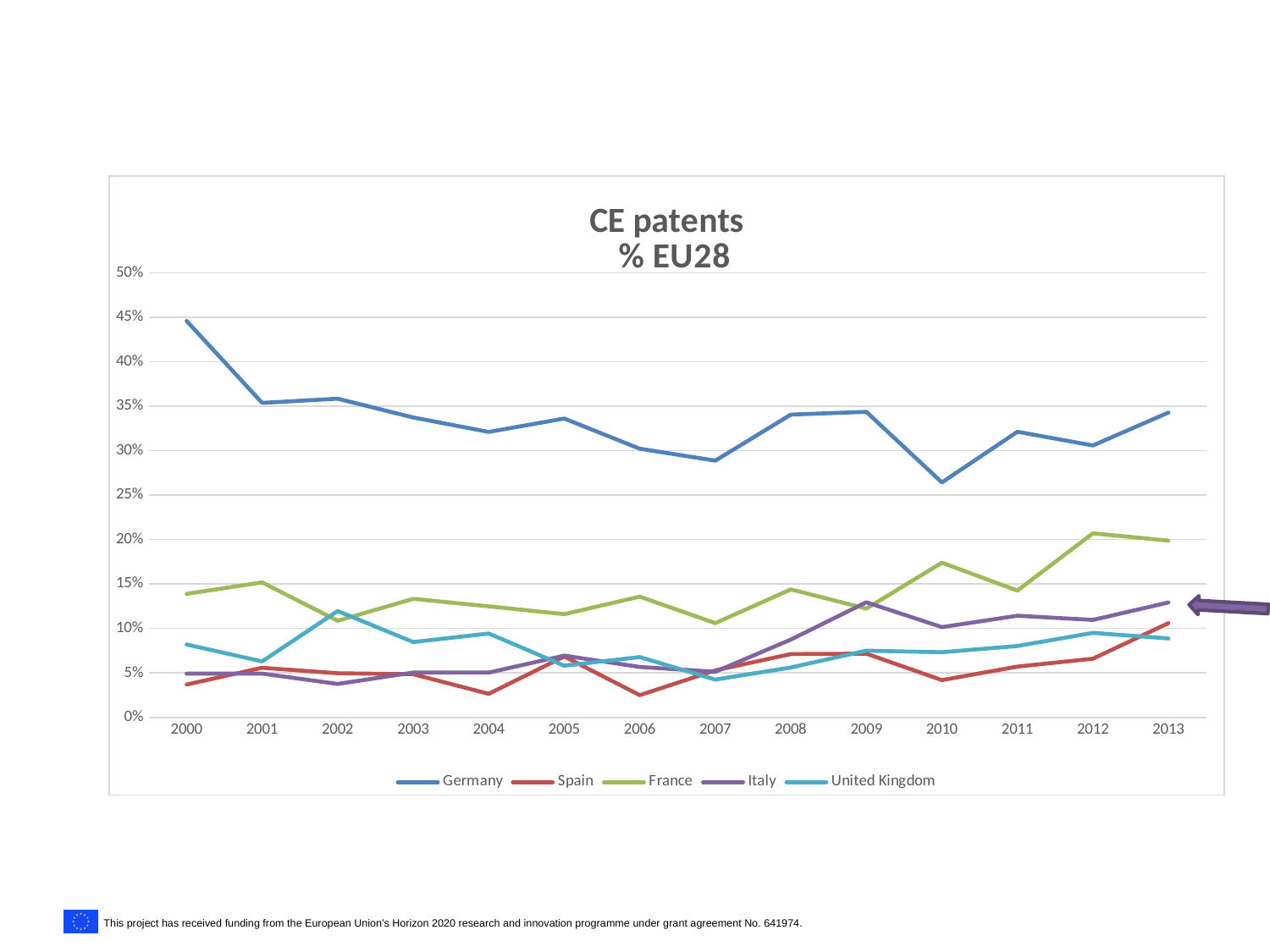
How many years are shown on the x axis? 14 Which is larger in 2013, the value for Germany or the value for France? Germany Is the value for France in 2012 greater or less than 15%? greater In which year is Germany's value highest? 2000 Which country has the highest share of CE patents across all years shown? Germany In which year is Germany's value lowest? 2010 What kind of chart is shown on the slide? line chart What is the title of the chart? CE patents % EU28 Is the value for Spain in 2006 greater or less than 5%? less How many series does the legend list? 5 Is the value for Germany in 2010 greater or less than 30%? less